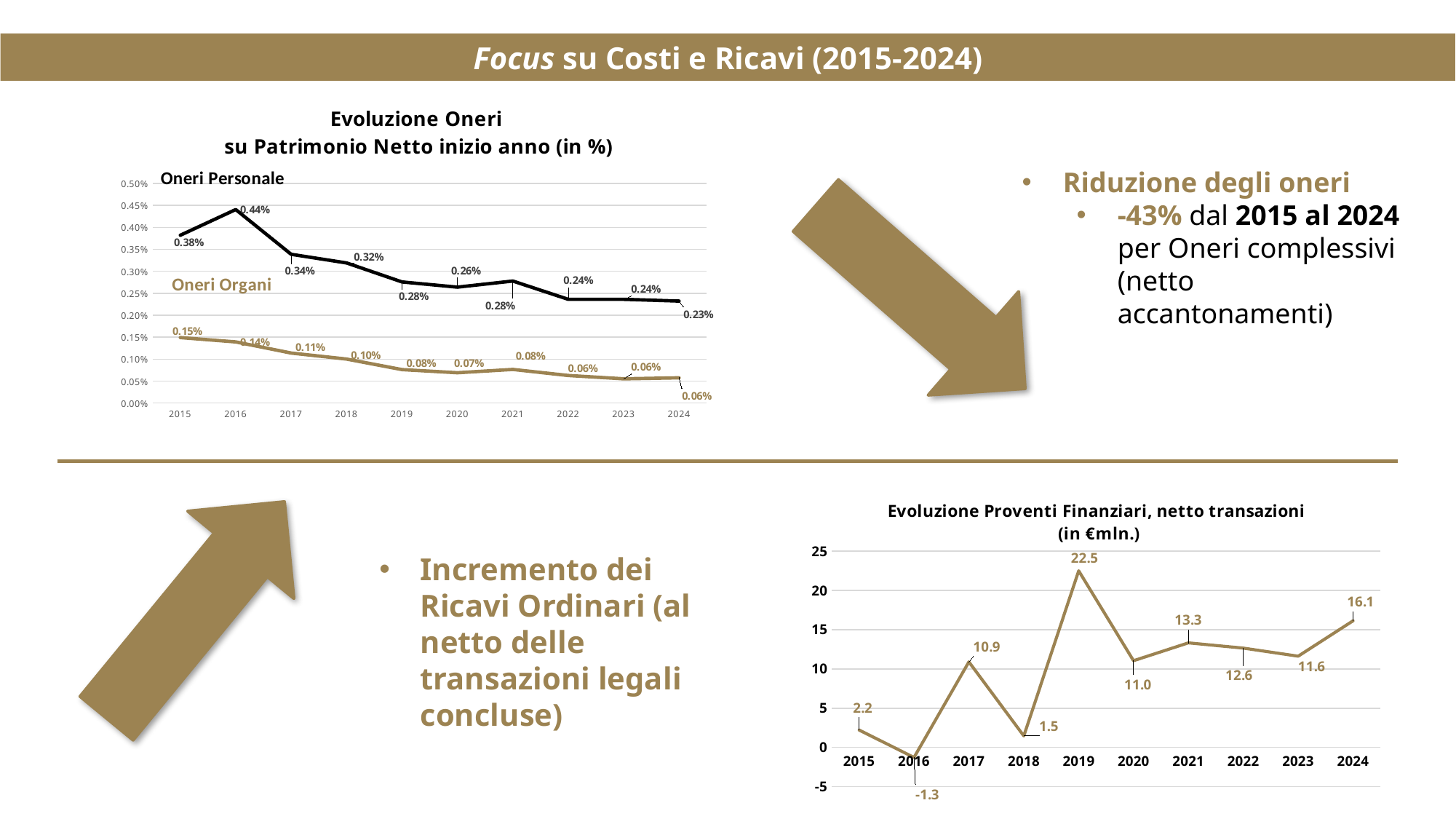
How many years are shown on the x axis of the 'Evoluzione Oneri su Patrimonio Netto inizio anno' chart? 10 In the 'Evoluzione Oneri su Patrimonio Netto inizio anno' chart, which year has the highest value for Oneri Personale? 2016 In the 'Evoluzione Oneri su Patrimonio Netto inizio anno' chart, what is the value for Oneri Organi in 2015? 0.15% In the 'Evoluzione Oneri su Patrimonio Netto inizio anno' chart, what is the difference between Oneri Personale and Oneri Organi in 2024? 0.17% In the 'Evoluzione Proventi Finanziari, netto transazioni' chart, which year has the lowest value? 2016 What type of chart is 'Evoluzione Oneri su Patrimonio Netto inizio anno'? line chart In the 'Evoluzione Proventi Finanziari, netto transazioni' chart, what unit is stated in the title? €mln. In the 'Evoluzione Oneri su Patrimonio Netto inizio anno' chart, does Oneri Personale generally rise or fall from 2016 to 2024? fall In the 'Evoluzione Proventi Finanziari, netto transazioni' chart, what is the value for 2019? 22.5 In the 'Evoluzione Proventi Finanziari, netto transazioni' chart, which is larger, the value for 2017 or the value for 2018? 2017 In the 'Evoluzione Proventi Finanziari, netto transazioni' chart, what is the difference between the values for 2024 and 2023? 4.5 In the 'Evoluzione Oneri su Patrimonio Netto inizio anno' chart, what is the value for Oneri Personale in 2016? 0.44%